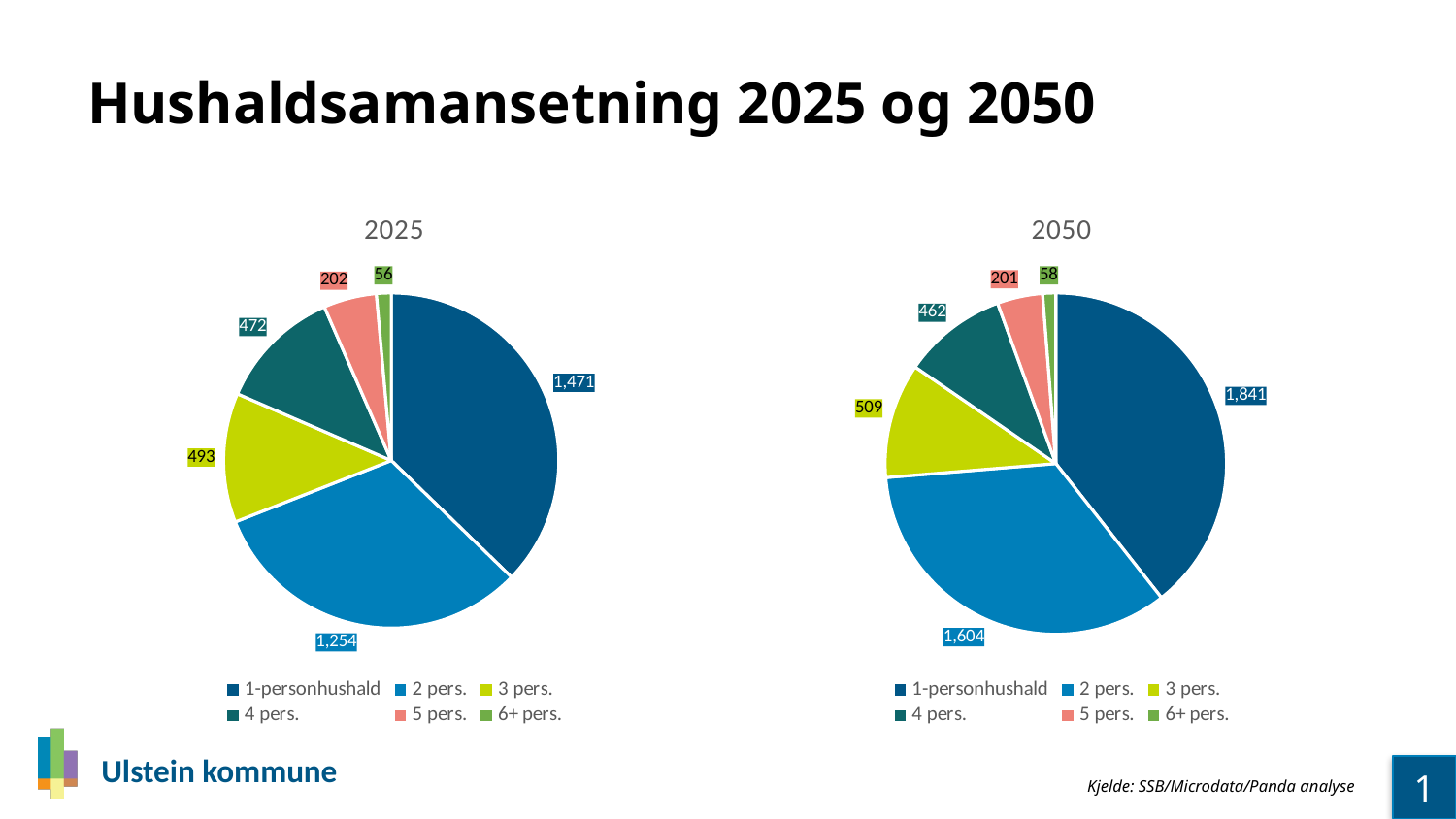
What type of chart is used for the 2025 data? Pie chart In the 2050 chart, what is the value for 6+ pers.? 58 How many entries does the legend of the 2050 chart list? 6 In the 2025 chart, what is the difference between the values for 2 pers. and 3 pers.? 761 In the 2025 chart, what is the value for 1-personhushald? 1,471 In the 2025 chart, which category has the smallest value? 6+ pers. In the 2050 chart, which is larger: 3 pers. or 4 pers.? 3 pers. In the 2050 chart, what is the value for 2 pers.? 1,604 What is the difference between the 1-personhushald value in the 2050 chart and in the 2025 chart? 370 In the 2025 chart, what is the value for 4 pers.? 472 How many categories does the 2025 pie chart show? 6 In the 2050 chart, which category has the largest value? 1-personhushald